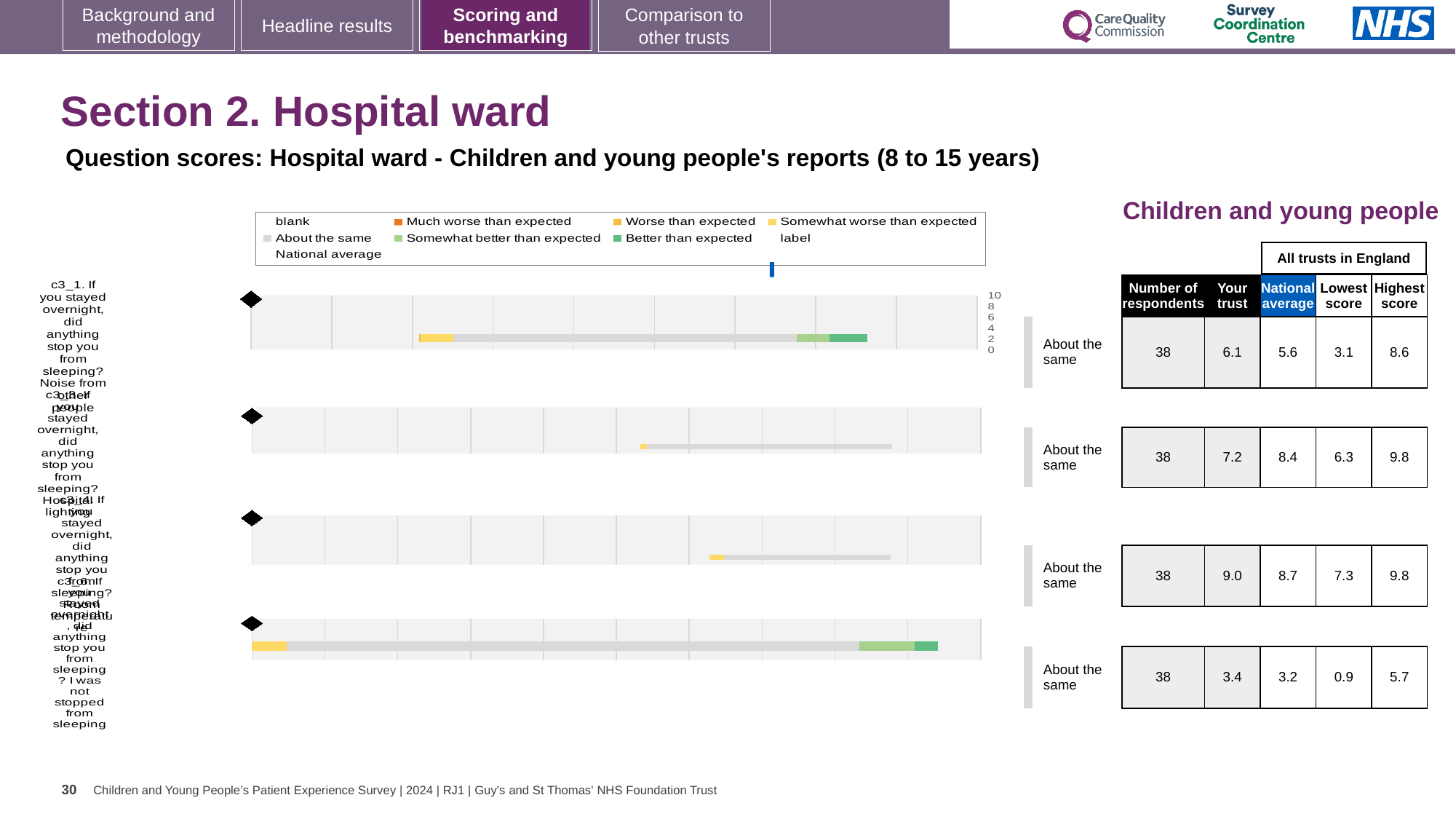
For the top chart (c3_1, noise from other people), what is the 'Your trust' score shown in the table beside it? 6.1 How many entries does the chart legend list? 9 For the top chart (c3_1, noise from other people), what is the national average shown in the table beside it? 5.6 For the bottom chart, what is the 'Your trust' score shown in the table beside it? 3.4 For the bottom chart, what is the highest score among all trusts in England shown in the table beside it? 5.7 What benchmark category is shown next to each of the four charts? About the same How many separate question charts are shown on the slide? 4 For the top chart (c3_1, noise from other people), what is the difference between the 'Your trust' score and the national average? 0.5 What is the highest value shown on the chart axis? 10 For the top chart (c3_1, noise from other people), is the 'Your trust' score higher or lower than the national average? higher What kind of chart is used to show the question scores on this slide? bar chart What colour does the legend use for 'Much worse than expected'? orange